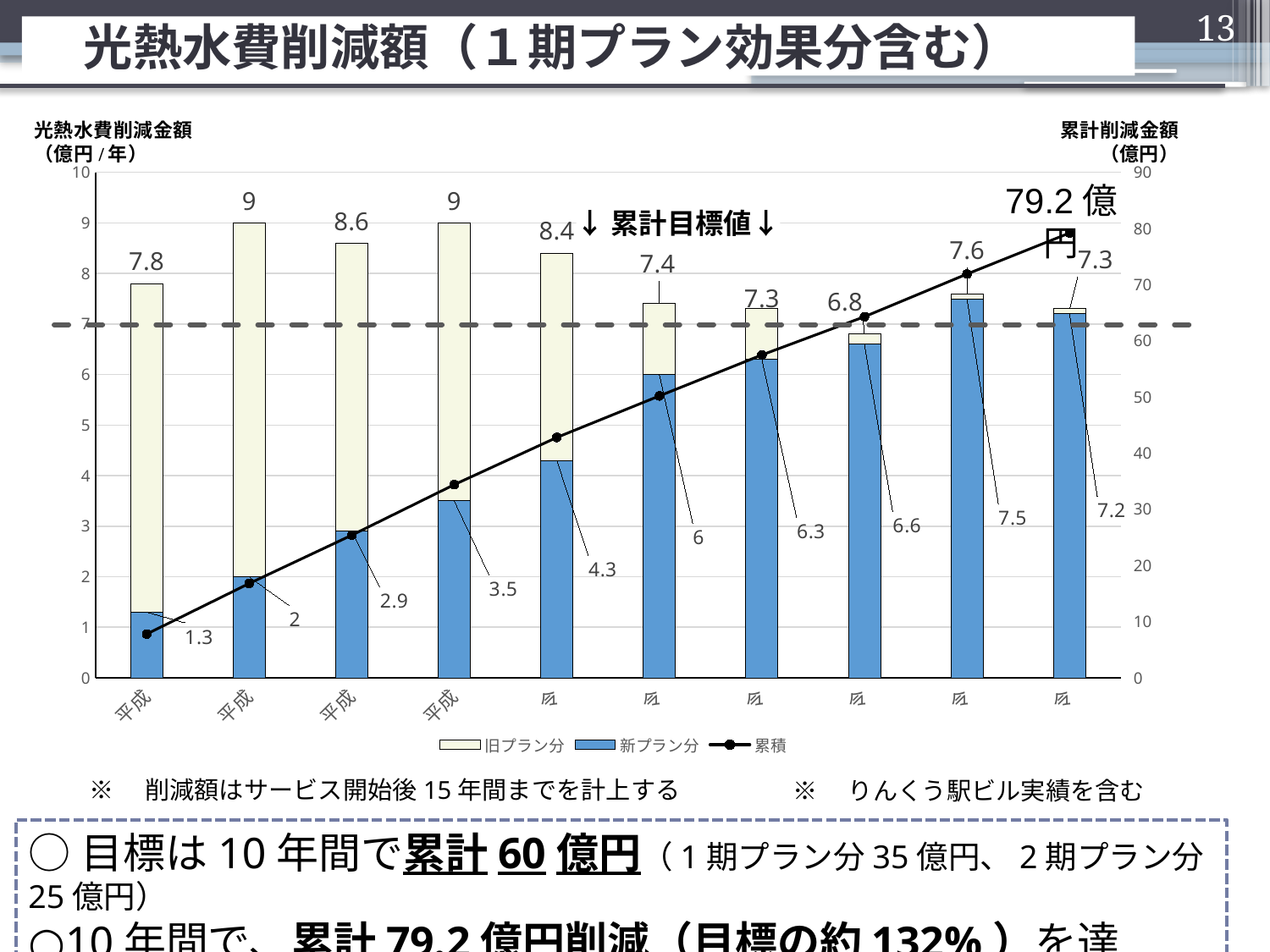
Does the 新プラン分 (blue) portion generally rise or fall from left to right across the bars? rise What is the difference between the total of the first bar (7.8) and its 新プラン分 portion (1.3)? 6.5 What is the final value of the 累積 line, as labelled at the top right of the chart? 79.2億円 Which is larger: the total of the first bar or the total of the last bar? The first bar (7.8) Is the 累積 line value at the fourth bar greater or less than 40 on the right axis? less What is the value of the 新プラン分 (blue) portion of the first bar? 1.3 What kind of chart is shown on the slide? A stacked bar chart combined with a line chart What is the largest 新プラン分 (blue) value labelled in the chart? 7.5 Which bar has the lowest total value labelled above it? The eighth bar (6.8) How many bars are plotted in the chart? 10 What is the total value labelled above the first bar in the chart? 7.8 How many series does the legend list? 3